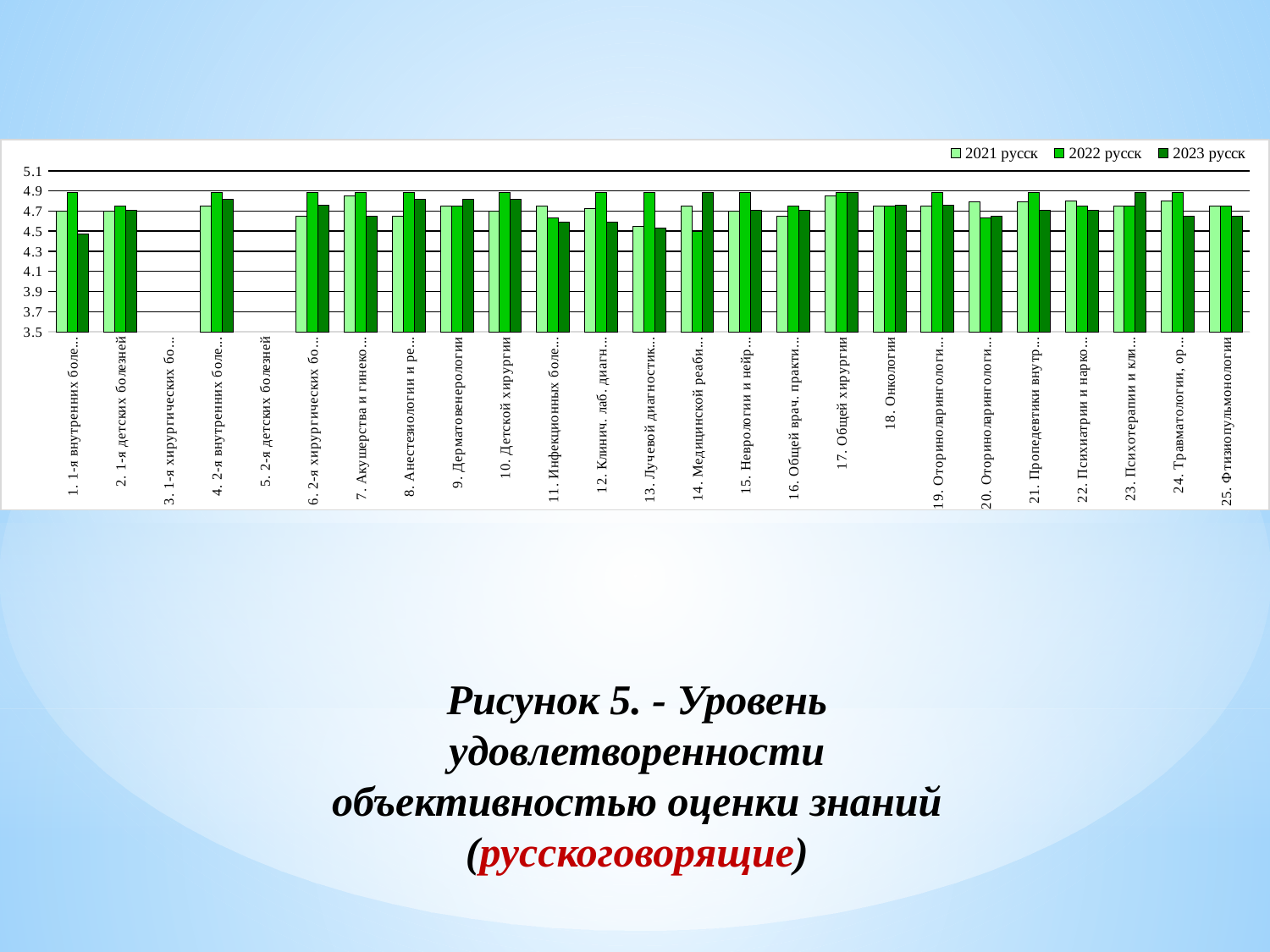
For '13. Лучевой диагностик...', which is larger: the 2022 русск value or the 2023 русск value? 2022 русск For '14. Медицинской реаби...', which is larger: the 2022 русск value or the 2023 русск value? 2023 русск Is the 2022 русск value for '12. Клинич. лаб. диагн...' greater or less than 4.7? greater How many series does the legend list? 3 Is the 2023 русск value for '17. Общей хирургии' greater or less than 4.7? greater What are the three series named in the legend? 2021 русск, 2022 русск, 2023 русск For '1. 1-я внутренних боле...', which is larger: the 2022 русск value or the 2023 русск value? 2022 русск Which two categories have no bars plotted? 3. 1-я хирургических бо... and 5. 2-я детских болезней Is the 2023 русск value for '1. 1-я внутренних боле...' greater or less than 4.7? less What kind of chart is shown on the slide? bar chart How many categories are labelled along the x axis? 25